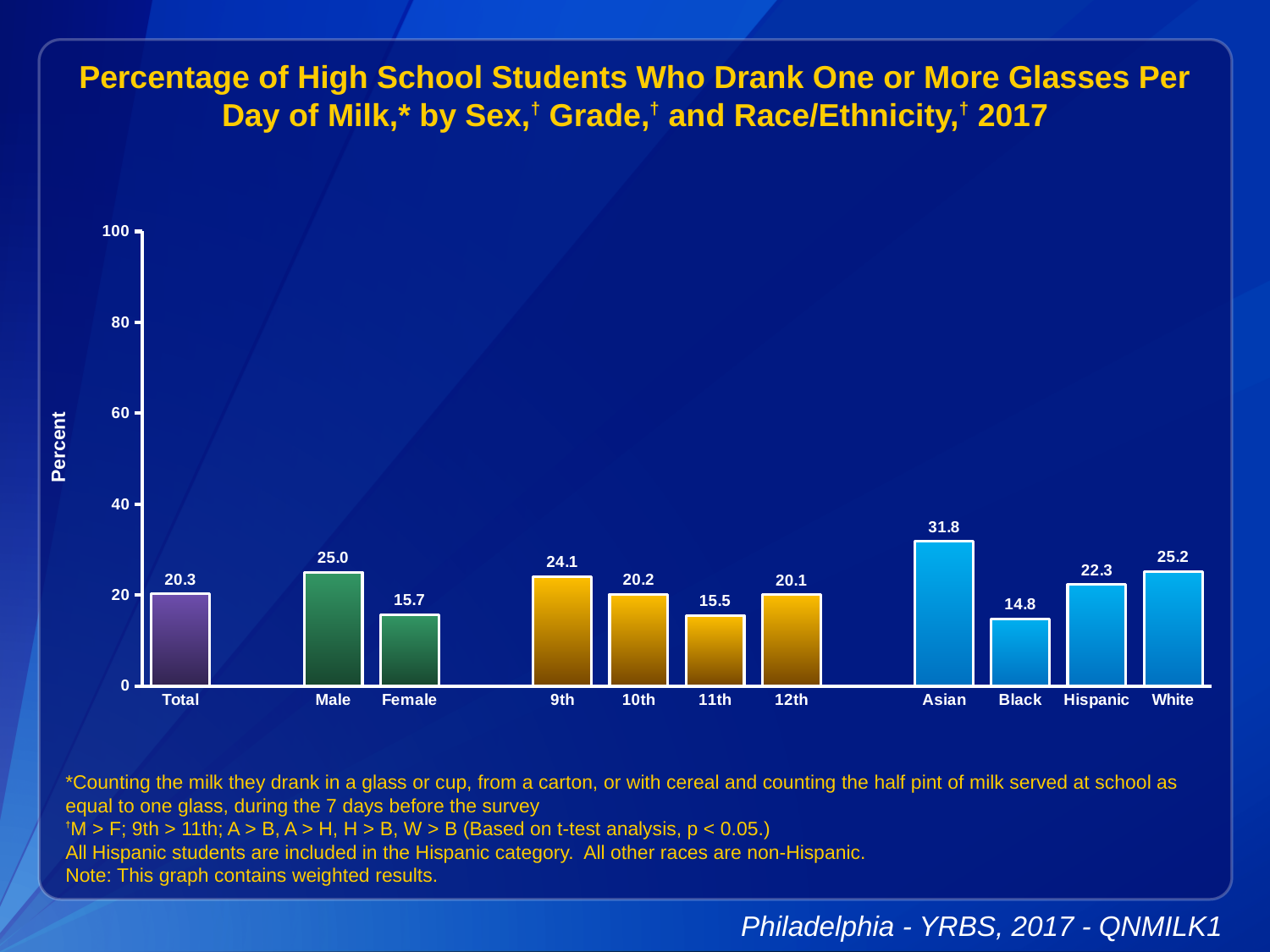
What is the difference between the Asian and Black values? 17.0 Which category has the highest value? Asian Is the value for White greater or less than 20? greater What is the value for Female? 15.7 What is the label of the y axis? Percent How many bars are shown in the chart? 11 What is the value for Asian? 31.8 What is the difference between the Male and Female values? 9.3 What kind of chart is this? bar chart What is the value for Total? 20.3 Which is larger, the value for 9th or the value for 11th? 9th Which category has the lowest value? Black